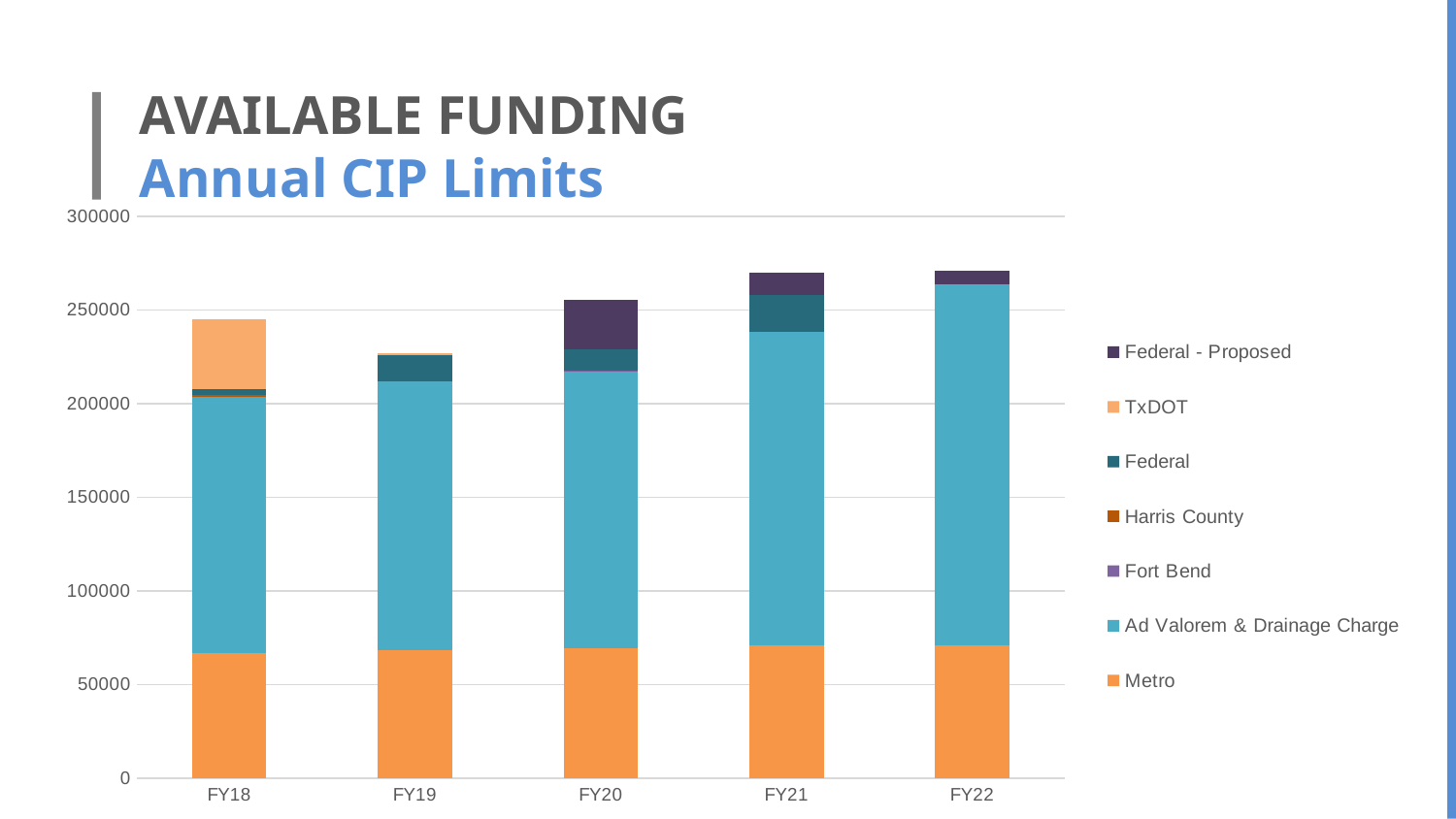
Which total bar is larger, FY18 or FY19? FY18 How many series does the legend list? 7 Is the Metro segment for FY18 greater or less than 50000? greater Which fiscal year has the largest Federal - Proposed segment? FY20 Does the Ad Valorem & Drainage Charge segment rise or fall from FY18 to FY22? rise Is the total bar for FY21 greater or less than 250000? greater Is the total bar for FY19 greater or less than 250000? less Which fiscal year has the lowest total bar? FY19 What kind of chart is shown on the slide? stacked bar chart How many fiscal years are shown on the x axis? 5